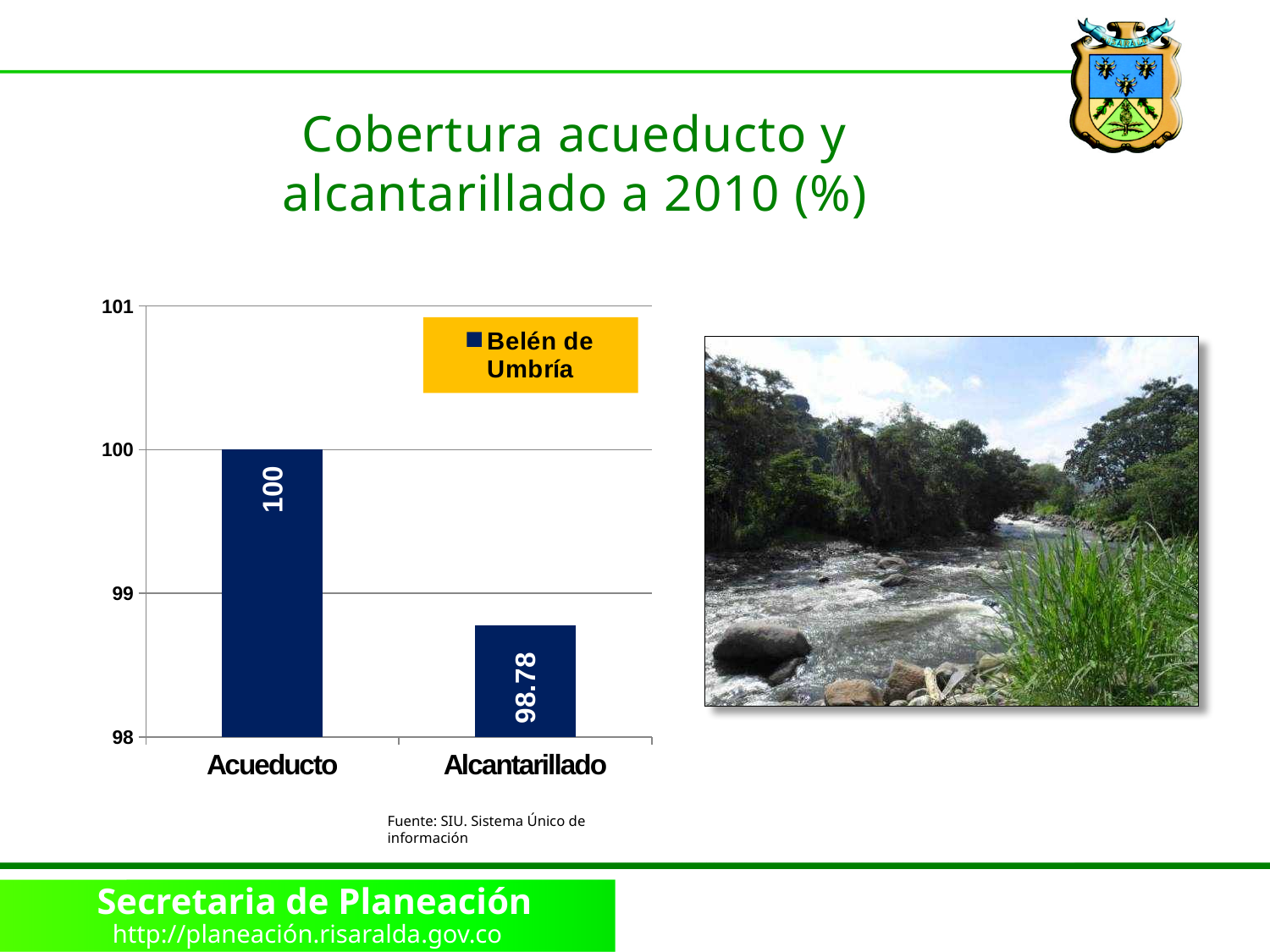
How many series does the legend list? 1 Which category has the highest value? Acueducto What is the difference between the values for Acueducto and Alcantarillado? 1.22 Which category has the lowest value? Alcantarillado What is the title of the chart on the slide? Cobertura acueducto y alcantarillado a 2010 (%) What series name is shown in the legend? Belén de Umbría Which is larger, the value for Acueducto or the value for Alcantarillado? Acueducto Is the value for Alcantarillado greater or less than 99? less What is the value for Acueducto? 100 What is the value for Alcantarillado? 98.78 What kind of chart is shown on the slide? bar chart How many categories are shown on the x axis? 2